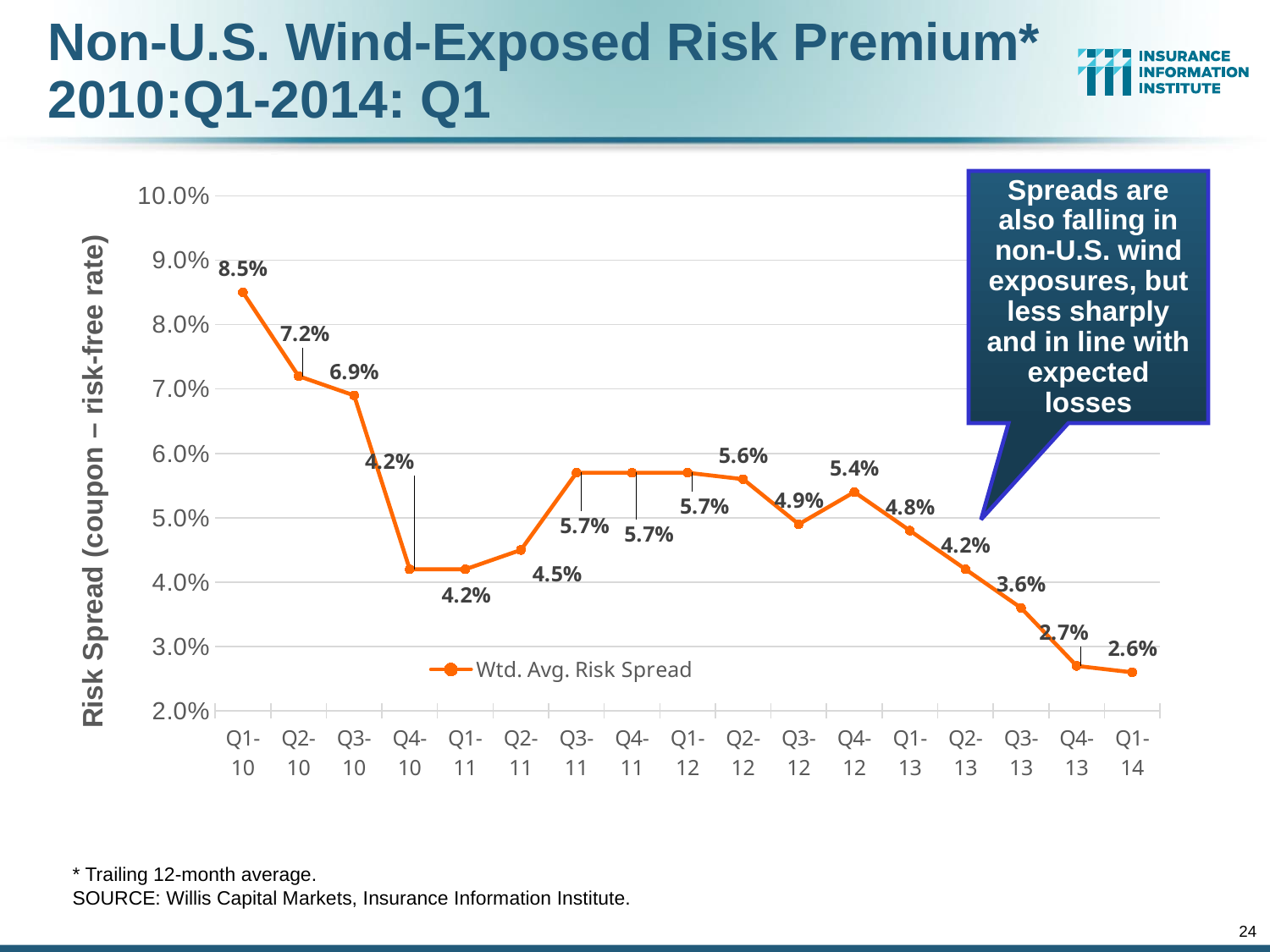
Which quarter has the highest weighted average risk spread? Q1-10 What is the difference between the risk spread in Q1-10 and Q2-10? 1.3% How many quarters are plotted on the chart? 17 What is the weighted average risk spread for Q1-10? 8.5% What is the weighted average risk spread for Q4-12? 5.4% Is the value for Q3-10 greater or less than 6.0%? greater What kind of chart is shown on the slide? Line chart What is the weighted average risk spread for Q1-14? 2.6% Which quarter has the lowest weighted average risk spread? Q1-14 What is the weighted average risk spread for Q3-12? 4.9% Which is larger, the risk spread in Q2-11 or in Q3-13? Q2-11 What series name is shown in the legend? Wtd. Avg. Risk Spread